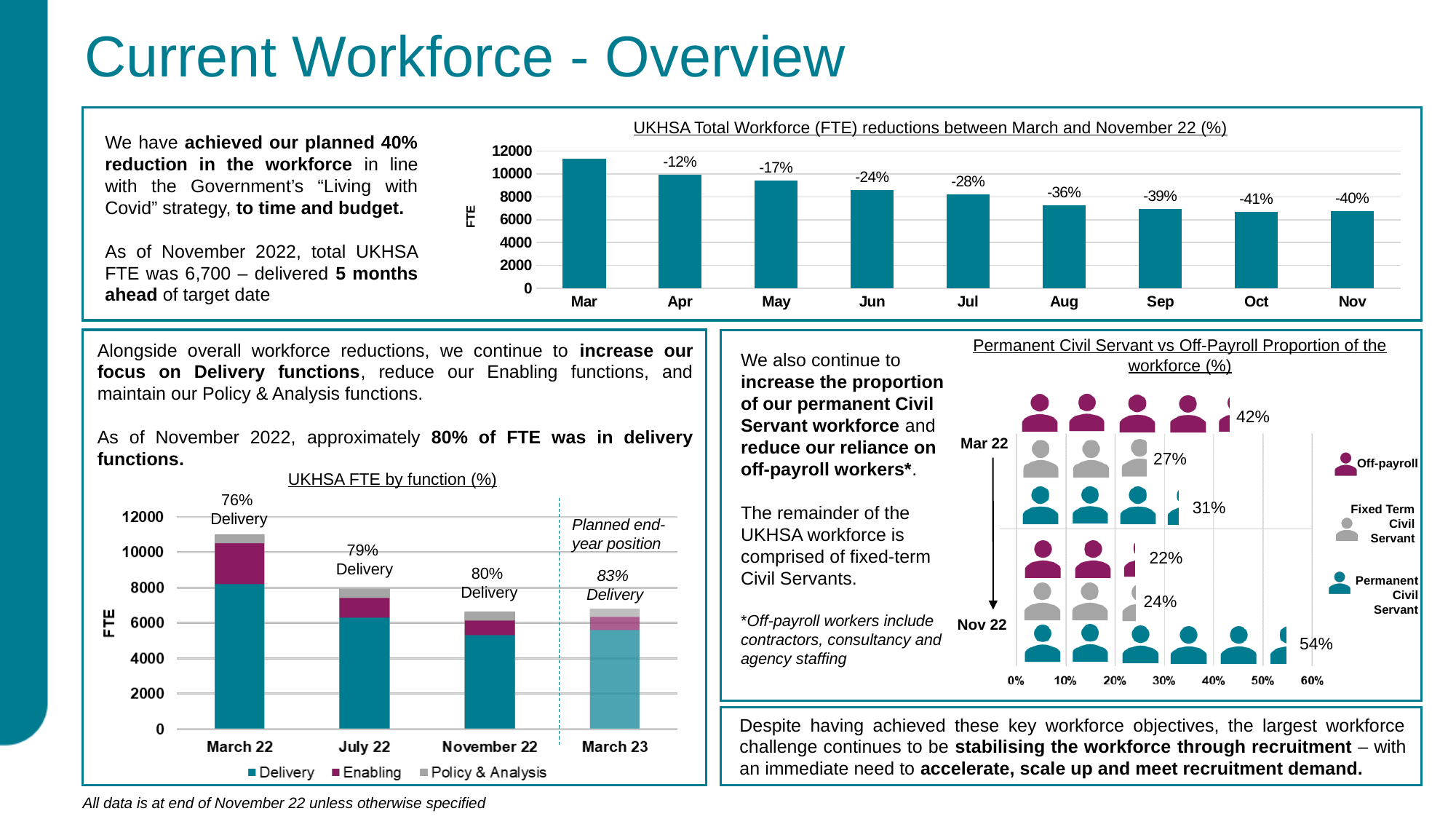
In the chart 'UKHSA Total Workforce (FTE) reductions between March and November 22 (%)', do the FTE values rise or fall from Mar to Nov? fall In the chart 'UKHSA Total Workforce (FTE) reductions between March and November 22 (%)', which month has the largest labelled reduction percentage? Oct What kind of chart is 'UKHSA FTE by function (%)'? stacked bar chart In the chart 'UKHSA FTE by function (%)', how many series does the legend list? 3 In the chart 'UKHSA FTE by function (%)', what percentage of FTE is labelled as Delivery for November 22? 80% In the chart 'Permanent Civil Servant vs Off-Payroll Proportion of the workforce (%)', what is the Permanent Civil Servant proportion for Nov 22? 54% In the chart 'Permanent Civil Servant vs Off-Payroll Proportion of the workforce (%)', by how many percentage points did the Off-payroll proportion fall from Mar 22 (42%) to Nov 22 (22%)? 20 percentage points In the chart 'UKHSA FTE by function (%)', is the total FTE for March 22 greater or less than 10000? greater In the chart 'UKHSA Total Workforce (FTE) reductions between March and November 22 (%)', how many months are shown on the x axis? 9 In the chart 'UKHSA Total Workforce (FTE) reductions between March and November 22 (%)', what reduction percentage is shown for Aug? -36% In the chart 'UKHSA Total Workforce (FTE) reductions between March and November 22 (%)', is the FTE value for Mar greater or less than 10000? greater In the chart 'UKHSA Total Workforce (FTE) reductions between March and November 22 (%)', what reduction percentage is shown for Nov? -40%